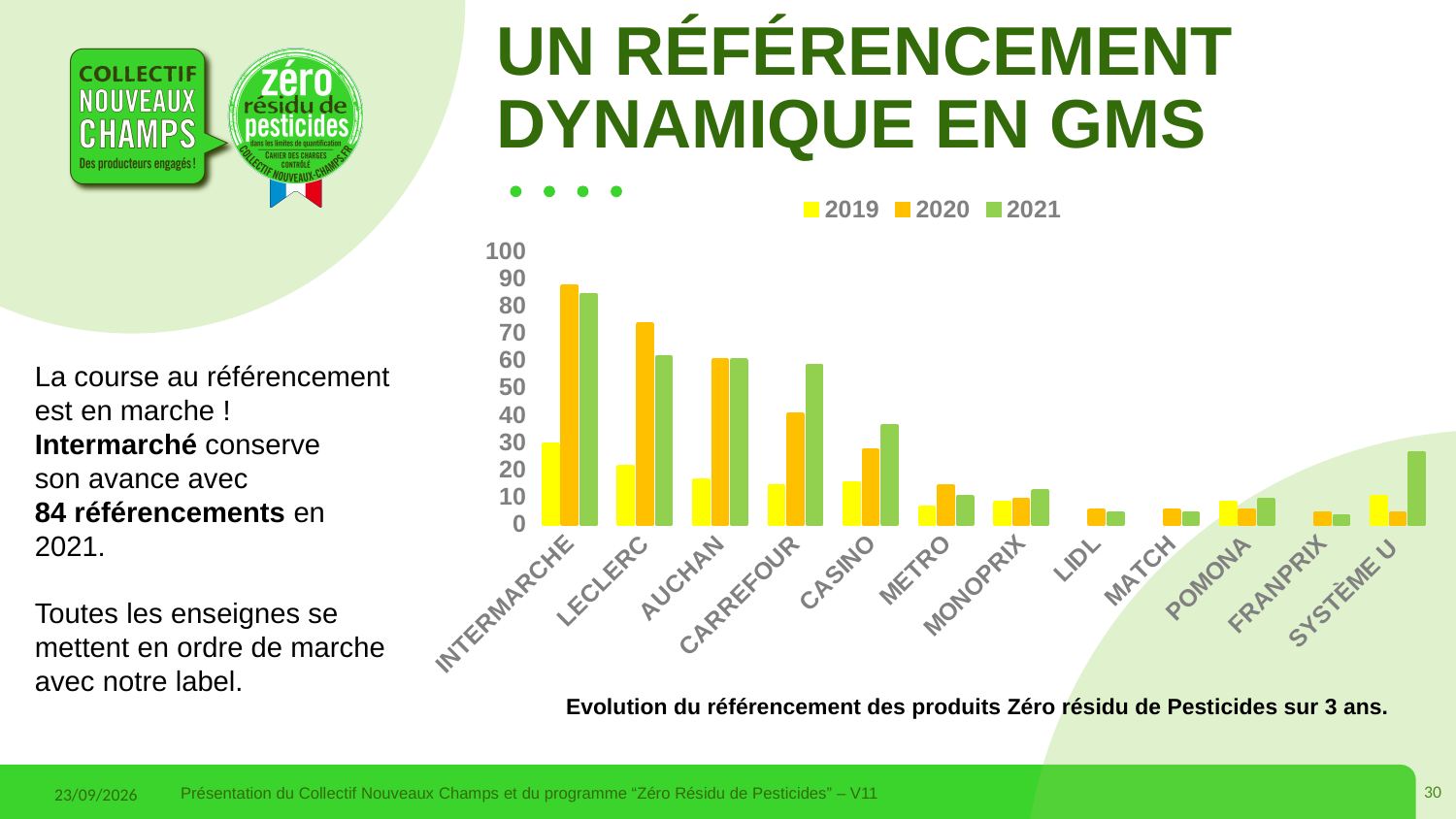
Which retailer has the highest 2021 bar in the chart? INTERMARCHE Which retailer has the highest 2020 bar in the chart? INTERMARCHE How many retailers (categories) are shown on the x axis of the chart? 12 Is the 2021 value for SYSTÈME U greater or less than 20? greater How many series does the chart legend list? 3 Is the 2021 value for CASINO greater or less than 30? greater Is the 2020 value for INTERMARCHE greater or less than 80? greater Which is larger: the 2020 value for LECLERC or the 2020 value for AUCHAN? LECLERC For CARREFOUR, which year has the larger bar: 2020 or 2021? 2021 Which colour represents the 2019 series in the chart legend? yellow What kind of chart is shown on the slide? bar chart